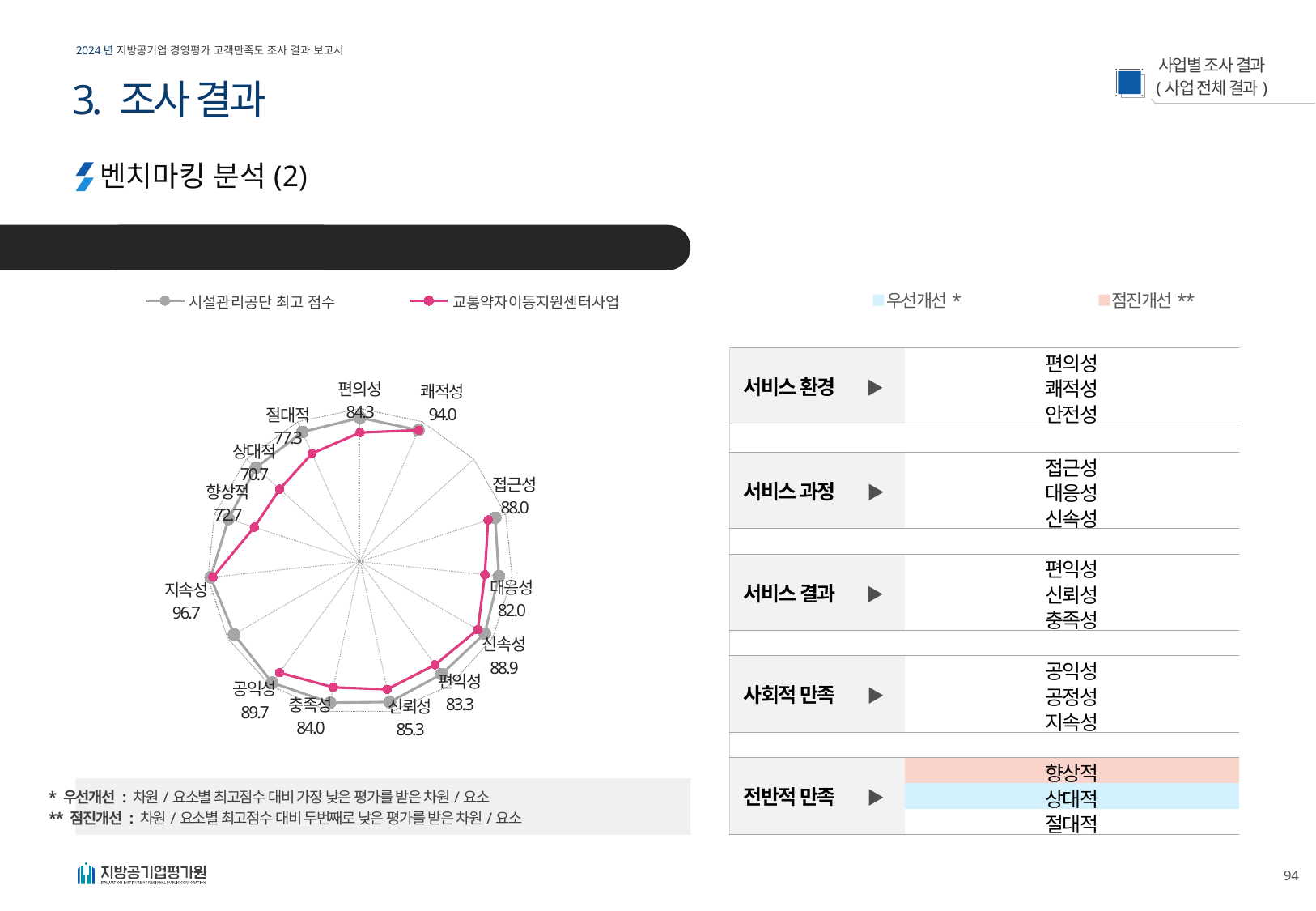
What value is labelled for 쾌적성 on the chart? 94.0 What value is labelled for 신뢰성 on the chart? 85.3 Which labelled category has the highest value on the chart? 지속성 What are the two series named in the chart legend? 시설관리공단 최고 점수, 교통약자이동지원센터사업 What kind of chart is shown on the slide? radar chart Which has the larger labelled value, 쾌적성 or 접근성? 쾌적성 What is the difference between the labelled values for 신속성 and 대응성? 6.9 How many series does the chart legend list? 2 What value is labelled for 지속성 on the chart? 96.7 Which labelled category has the lowest value on the chart? 상대적 What is the difference between the labelled values for 지속성 and 상대적? 26.0 What value is labelled for 상대적 on the chart? 70.7